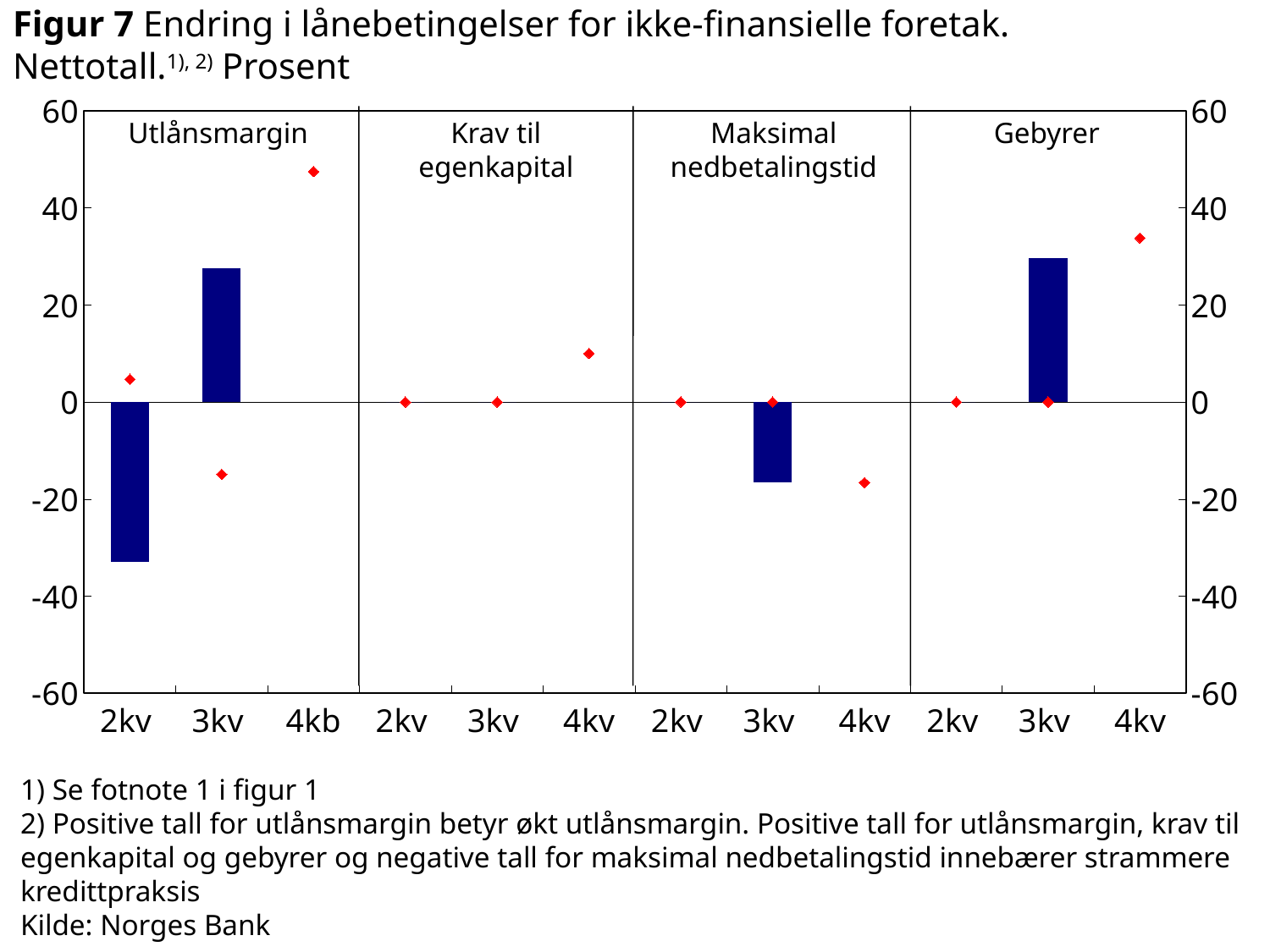
In the Maksimal nedbetalingstid panel, is the bar for 3kv greater or less than 0? less In the Utlånsmargin panel, is the bar for 2kv greater or less than -20? less In the Utlånsmargin panel, is the bar for 3kv greater or less than 20? greater Which is larger: the bar for 3kv in the Utlånsmargin panel or the bar for 3kv in the Maksimal nedbetalingstid panel? Utlånsmargin 3kv How many panels (categories of lending conditions) does the chart show? 4 What kind of chart is shown in Figur 7? combination chart with bars and red diamond markers Across all four panels, which quarter and panel has the lowest bar? 2kv in Utlånsmargin In the Krav til egenkapital panel, what value does the red marker for 2kv show? 0 What is the source cited below the chart? Norges Bank